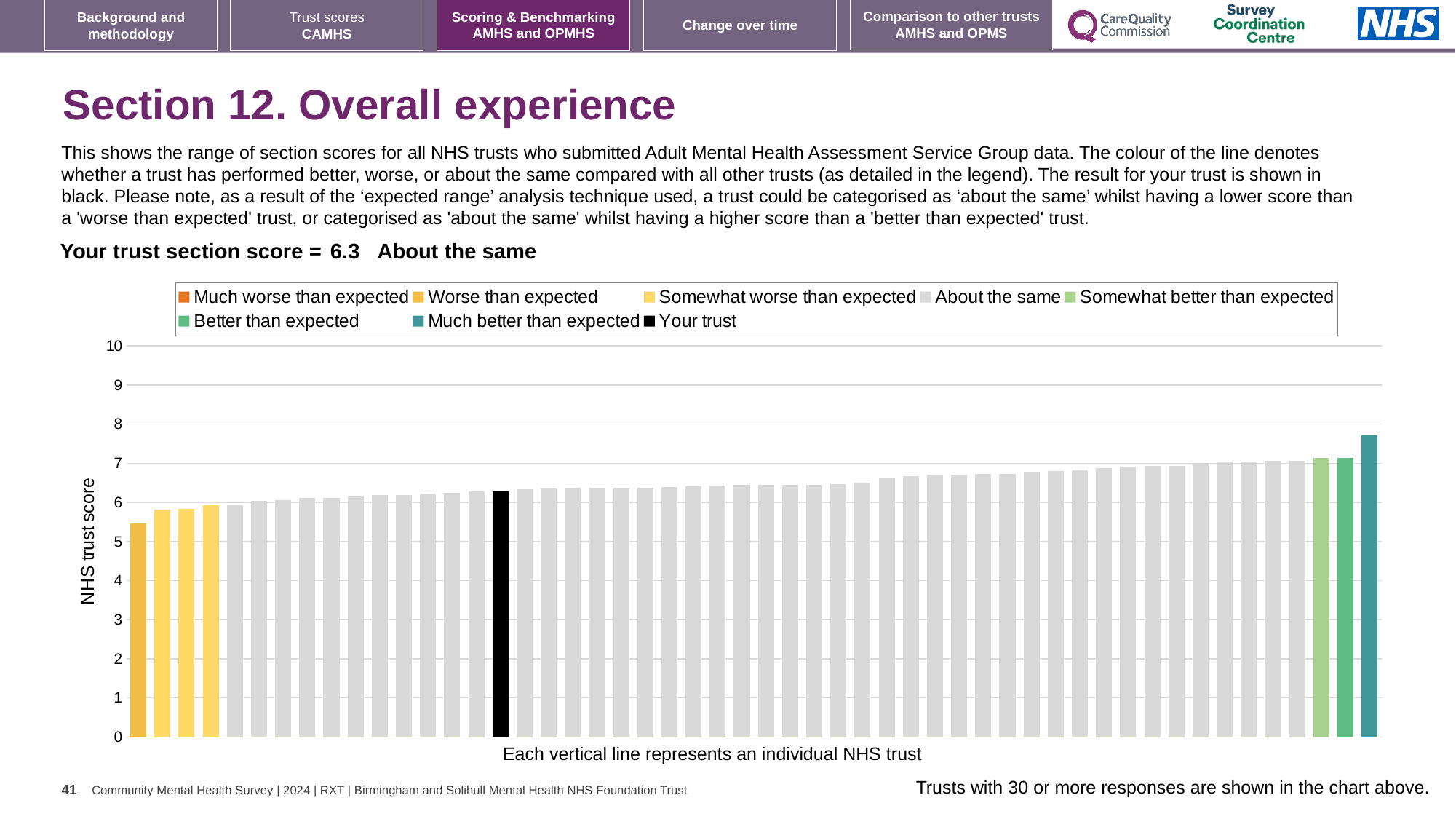
How many entries does the chart legend list? 8 How many yellow bars are shown at the left of the chart? 4 Is the value of the lowest bar on the chart greater or less than 5? greater Is the value of the lowest bar on the chart greater or less than 6? less What colour is the bar representing your trust? black Is the value of the black 'Your trust' bar greater or less than 7? less Do the bar values rise or fall from left to right across the chart? rise Which category is your trust placed in for this section? About the same What is the label on the vertical axis of the chart? NHS trust score What is the section score for your trust shown on the slide? 6.3 What kind of chart is shown on the slide? bar chart